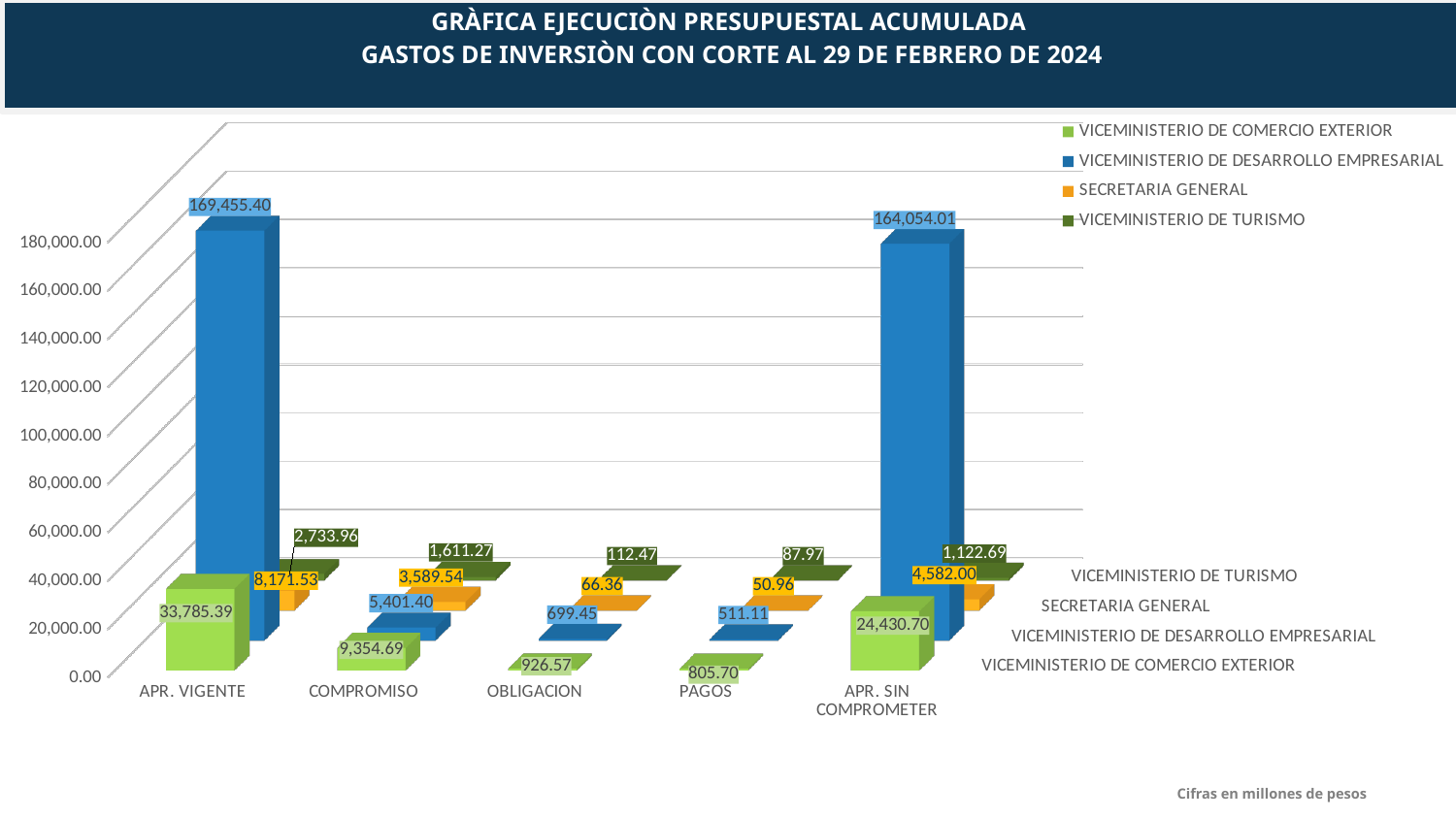
What is the value for SECRETARIA GENERAL in the COMPROMISO category? 3,589.54 What kind of chart is shown on the slide? Bar chart What is the value for VICEMINISTERIO DE DESARROLLO EMPRESARIAL in the APR. VIGENTE category? 169,455.40 Which is larger for VICEMINISTERIO DE COMERCIO EXTERIOR: the COMPROMISO value or the OBLIGACION value? COMPROMISO Which series has the highest value in the APR. VIGENTE category? VICEMINISTERIO DE DESARROLLO EMPRESARIAL How many categories are shown on the x axis? 5 How many series does the legend list? 4 What is the difference between the VICEMINISTERIO DE DESARROLLO EMPRESARIAL values for APR. VIGENTE and APR. SIN COMPROMETER? 5,401.39 According to the note on the slide, in what units are the figures expressed? Millones de pesos Which series has the lowest value in the OBLIGACION category? SECRETARIA GENERAL What is the value for VICEMINISTERIO DE TURISMO in the PAGOS category? 87.97 What is the value for VICEMINISTERIO DE COMERCIO EXTERIOR in the APR. SIN COMPROMETER category? 24,430.70